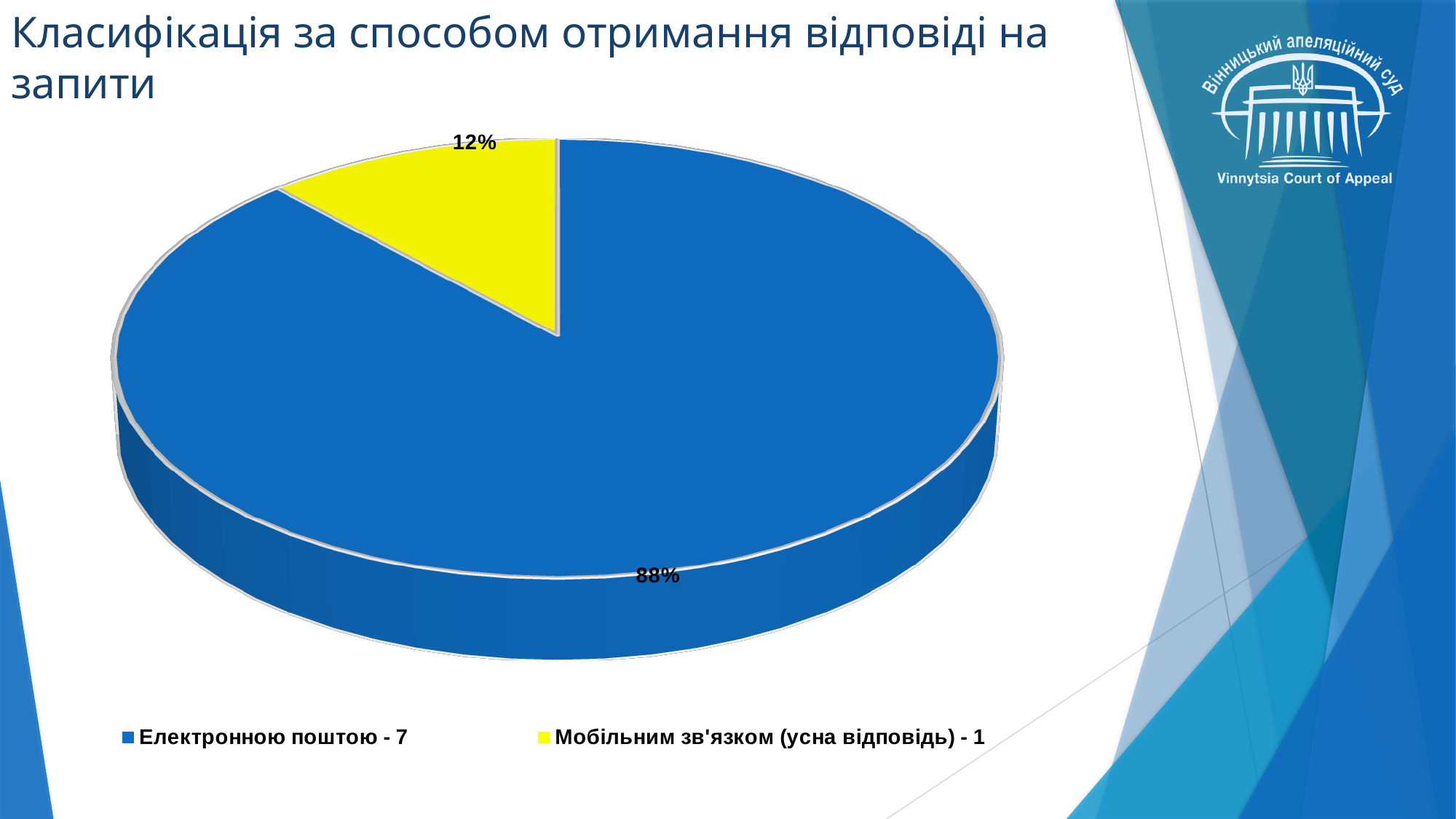
According to the legend, how many responses were received by e-mail ('Електронною поштою')? 7 What is the difference in percentage points between the two slices of the pie chart? 76 How many entries does the legend list? 2 What is the title of the slide containing the chart? Класифікація за способом отримання відповіді на запити How many slices does the pie chart have? 2 Which slice is larger: 'Електронною поштою' or 'Мобільним зв'язком (усна відповідь)'? Електронною поштою What colour is the slice for 'Мобільним зв'язком (усна відповідь) - 1'? Yellow What percentage of the pie chart is labelled for 'Мобільним зв'язком (усна відповідь) - 1'? 12% Which category has the smallest share of the pie chart? Мобільним зв'язком (усна відповідь) - 1 What kind of chart is shown on the slide? Pie chart Which category has the largest share of the pie chart? Електронною поштою - 7 What percentage of the pie chart is labelled for 'Електронною поштою - 7'? 88%